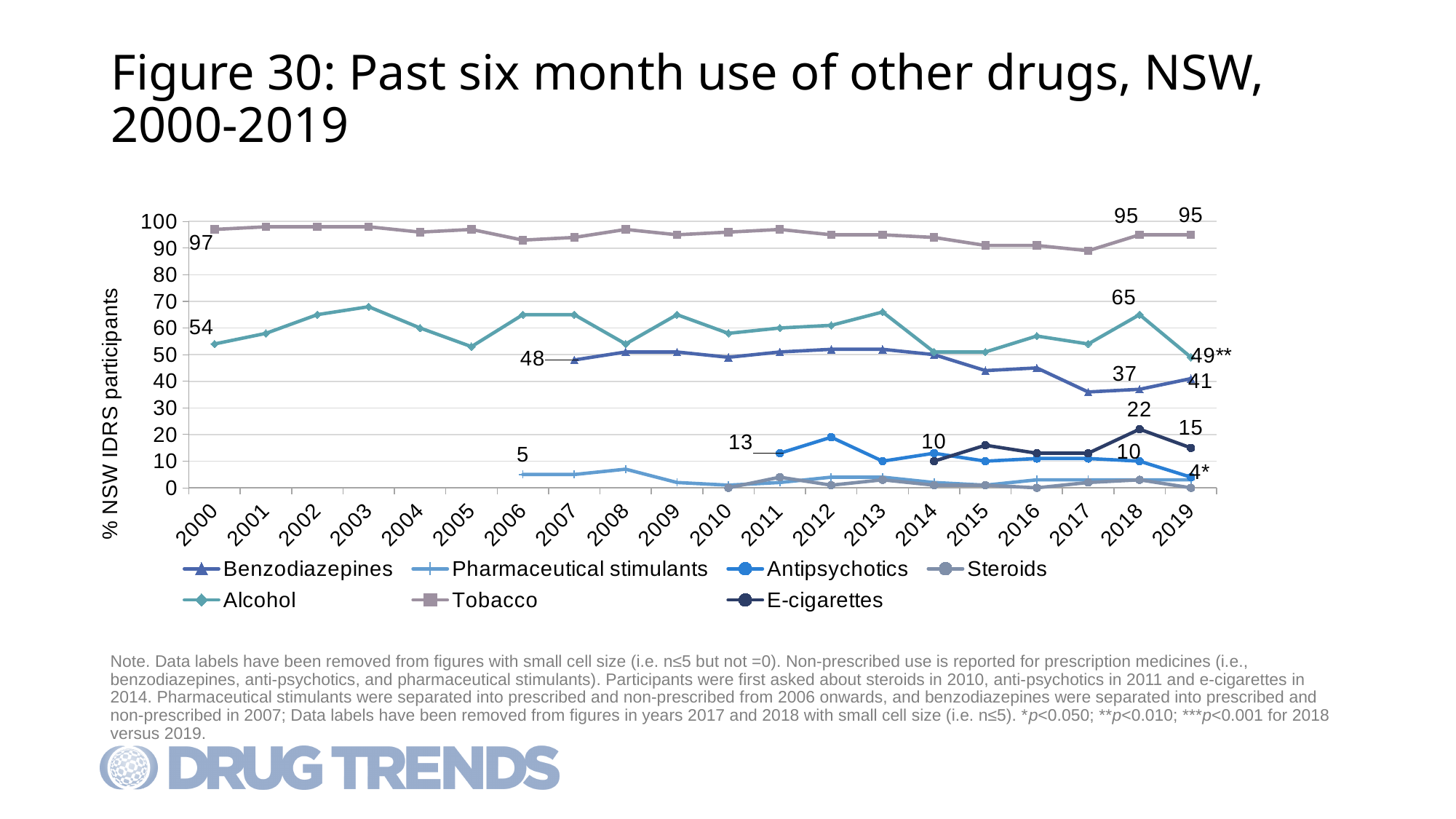
Is the value for Alcohol in 2003 greater or less than 60? greater What is the difference between the E-cigarettes values in 2018 and 2019? 7 What is the value for Benzodiazepines in 2007? 48 How many series does the legend list? 7 Which series has the highest value in 2019? Tobacco What kind of chart is shown on the slide? Line chart What is the value for Tobacco in 2000? 97 What is the value for E-cigarettes in 2018? 22 How many years are shown on the x axis? 20 What is the difference between the Alcohol values in 2018 and 2019? 16 Which is larger, the Benzodiazepines value in 2018 or in 2019? 2019 What is the value for Alcohol in 2018? 65